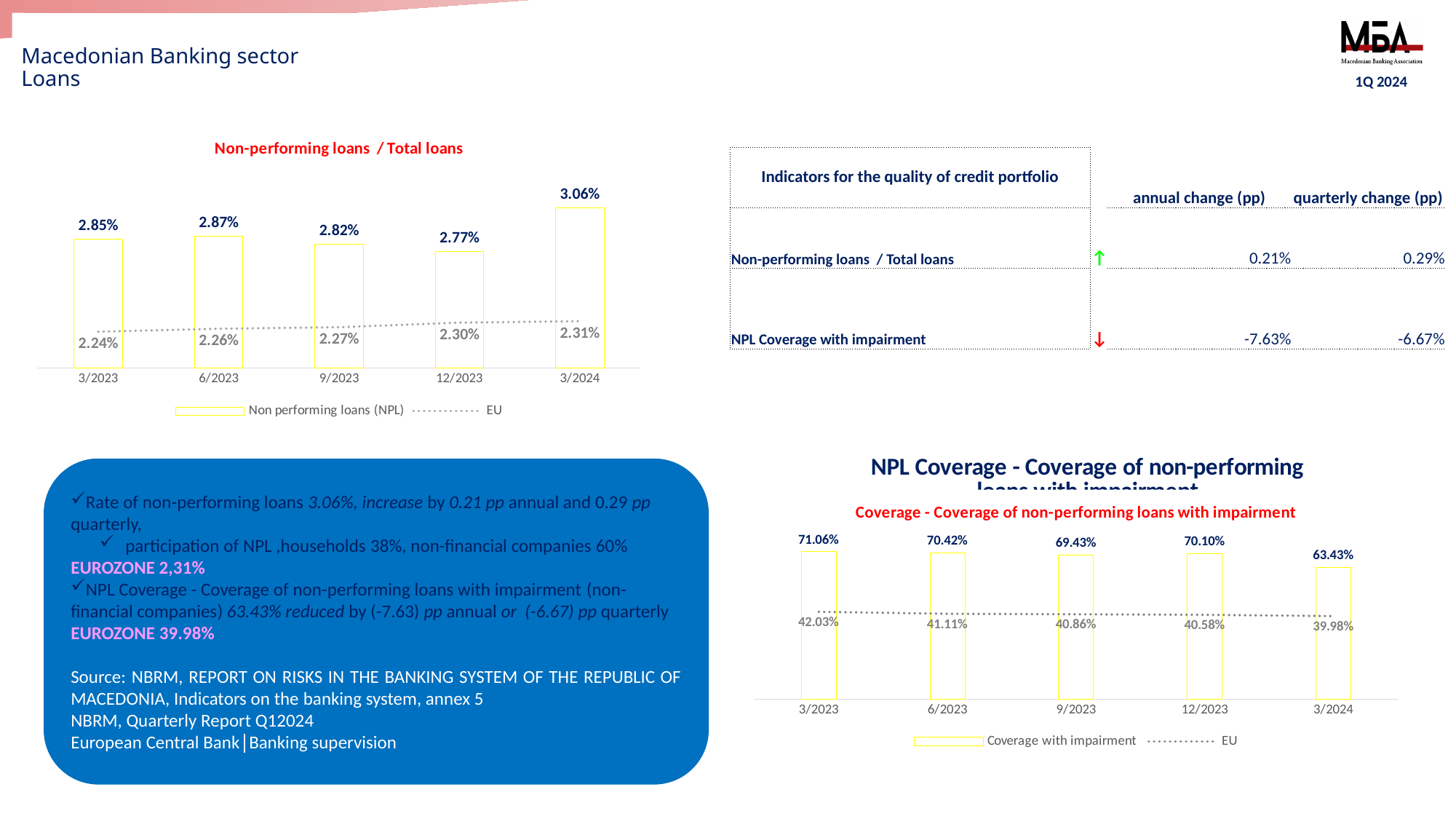
In the 'Non-performing loans / Total loans' chart, what is the difference between the NPL value and the EU value for 3/2024? 0.75% In the 'Non-performing loans / Total loans' chart, what is the EU value for 12/2023? 2.30% In the 'Coverage - Coverage of non-performing loans with impairment' chart, how many series does the legend list? 2 In the 'Coverage - Coverage of non-performing loans with impairment' chart, what is the EU value for 9/2023? 40.86% In the 'Coverage - Coverage of non-performing loans with impairment' chart, is the Coverage with impairment value for 6/2023 larger or smaller than for 12/2023? larger In the 'Coverage - Coverage of non-performing loans with impairment' chart, what is the Coverage with impairment value for 3/2024? 63.43% What kind of chart is the 'Coverage - Coverage of non-performing loans with impairment' chart? bar chart with a line In the 'Non-performing loans / Total loans' chart, what is the NPL value for 3/2024? 3.06% In the 'Non-performing loans / Total loans' chart, how many periods are shown on the x axis? 5 In the 'Non-performing loans / Total loans' chart, which period has the lowest Non performing loans (NPL) value? 12/2023 In the 'Non-performing loans / Total loans' chart, does the EU dotted line rise or fall from 3/2023 to 3/2024? rise In the 'Coverage - Coverage of non-performing loans with impairment' chart, which period has the highest Coverage with impairment value? 3/2023